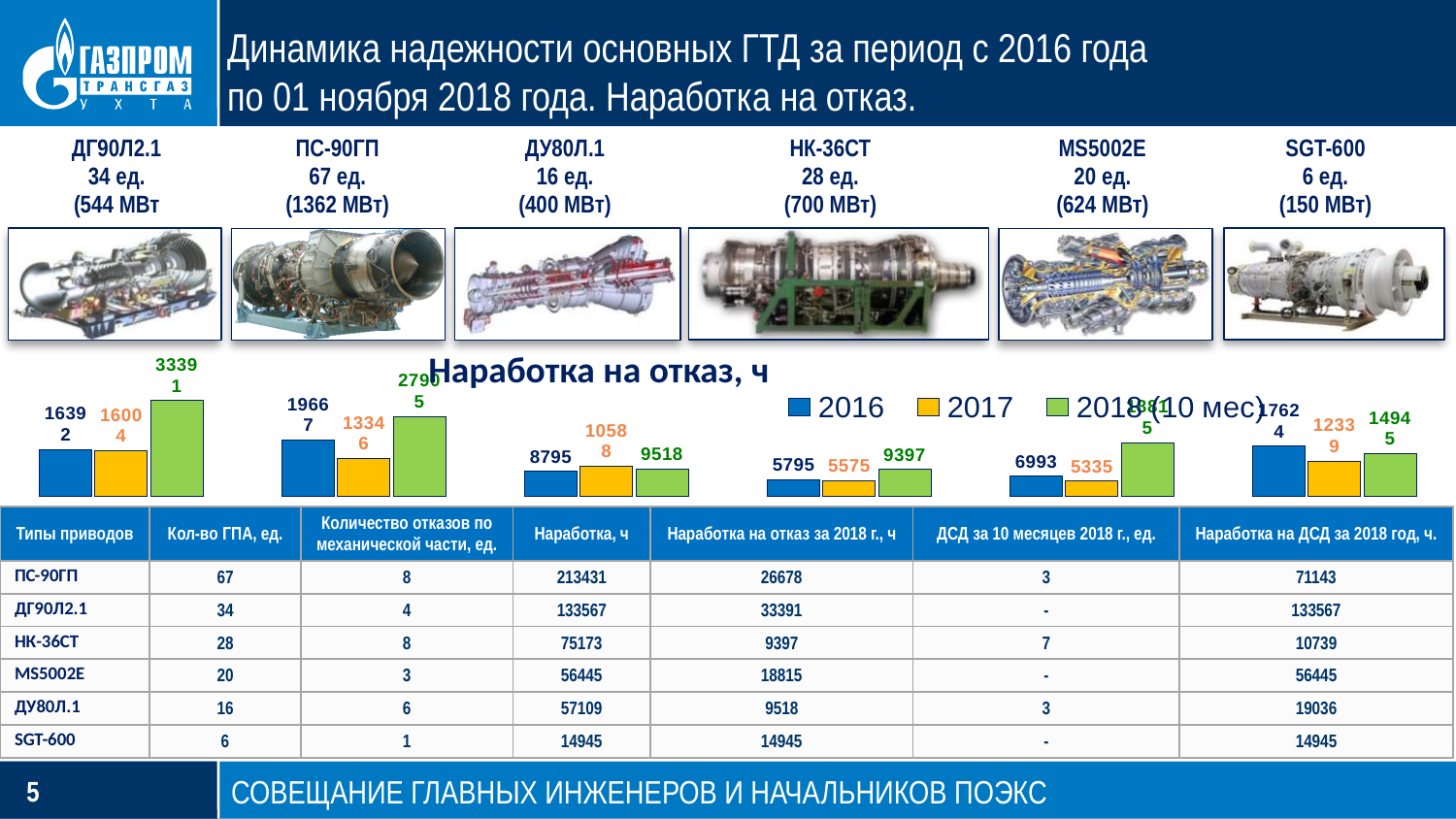
What are the legend entries of the "Наработка на отказ, ч" chart? 2016, 2017, 2018 (10 мес) How many series does the legend of the "Наработка на отказ, ч" chart list? 3 What kind of chart is the "Наработка на отказ, ч" chart? bar chart How many groups of bars are plotted in the "Наработка на отказ, ч" chart? 6 In the "Наработка на отказ, ч" chart, which is larger in the group under НК-36СТ: the 2016 value or the 2017 value? 2016 In the "Наработка на отказ, ч" chart, which series has the highest bar in the group under ДГ90Л2.1? 2018 (10 мес) In the "Наработка на отказ, ч" chart, what is the difference between the 2016 and 2017 values in the group under MS5002E? 1658 In the "Наработка на отказ, ч" chart, what is the 2017 value in the group under НК-36СТ? 5575 In the "Наработка на отказ, ч" chart, what is the 2016 value in the group under ДУ80Л.1? 8795 In the "Наработка на отказ, ч" chart, what is the 2018 (10 мес) value in the group under ДУ80Л.1? 9518 In the "Наработка на отказ, ч" chart, what is the difference between the 2018 (10 мес) and 2017 values in the group under НК-36СТ? 3822 In the "Наработка на отказ, ч" chart, what is the 2018 (10 мес) value in the group under НК-36СТ? 9397